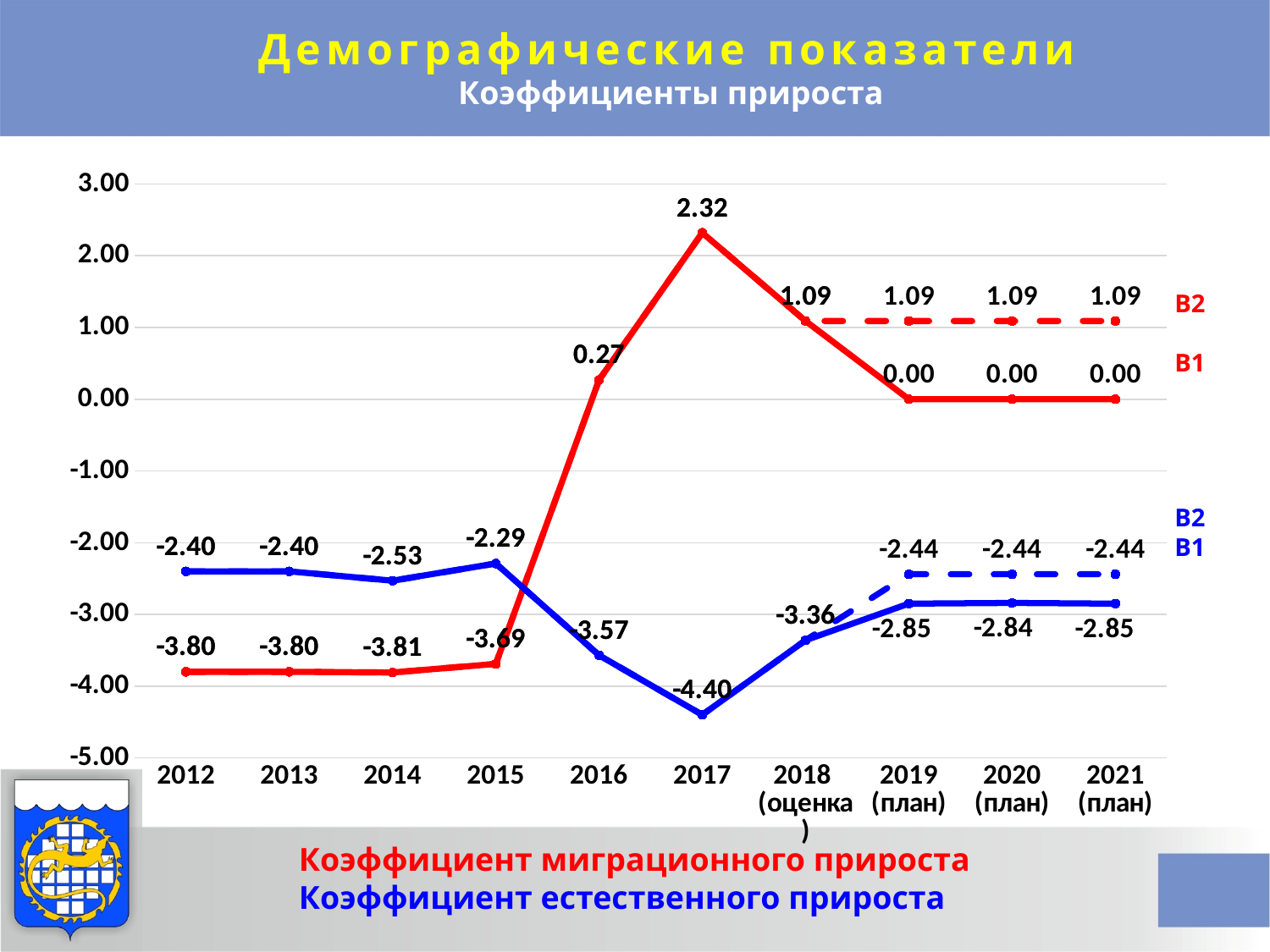
How many years are shown on the x axis of the chart? 10 What is the value of the natural growth coefficient (blue line) in 2017? -4.40 Which is larger in 2015: the migration growth coefficient or the natural growth coefficient? natural growth coefficient What is the value of the natural growth coefficient in 2018 (оценка)? -3.36 What is the difference between the migration growth coefficient in 2017 and in 2016? 2.05 What is the value of the migration growth coefficient (red line) in 2017? 2.32 What type of chart is shown on the slide? line chart What is the value of the migration growth coefficient in 2012? -3.80 What is the planned value of the natural growth coefficient in 2020 under variant B1? -2.84 In which year does the natural growth coefficient (blue line) reach its lowest value? 2017 What is the planned value of the migration growth coefficient in 2021 under variant B2? 1.09 In which year does the migration growth coefficient (red line) reach its highest value? 2017